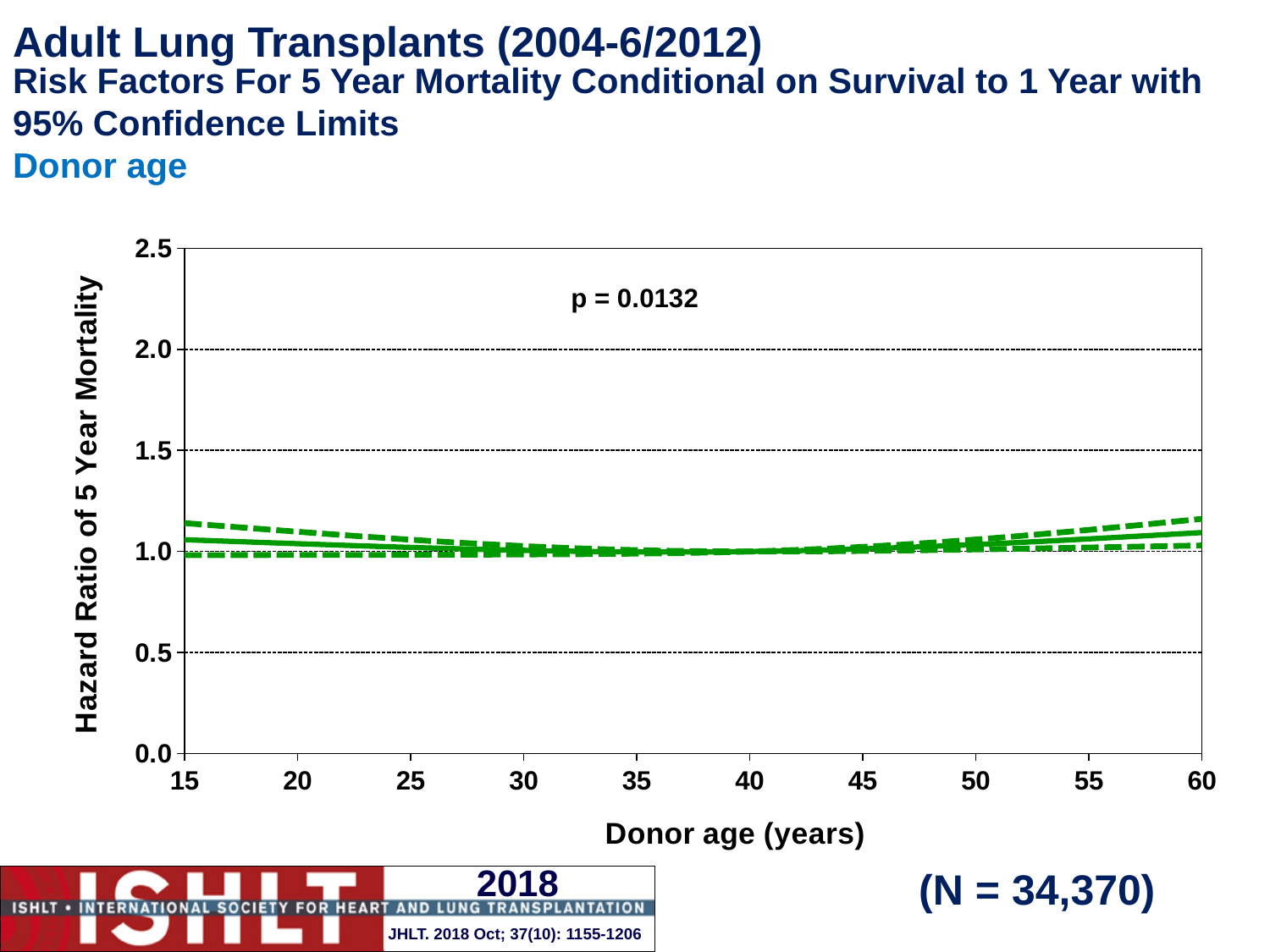
What is the label of the x axis? Donor age (years) Is the hazard ratio at donor age 60 greater or less than 1.5? less Is the hazard ratio at donor age 40 greater or less than 0.5? greater What kind of chart is shown on the slide? line chart What p-value is printed on the chart? p = 0.0132 What is the highest value shown on the y axis? 2.5 Is the hazard ratio at donor age 15 greater or less than 1.5? less Does the hazard ratio curve rise or fall between donor age 45 and donor age 60? rises What is the lowest donor age shown on the x axis? 15 How many lines are plotted on the chart (including the confidence limit lines)? 3 Does the hazard ratio curve rise or fall between donor age 15 and donor age 35? falls